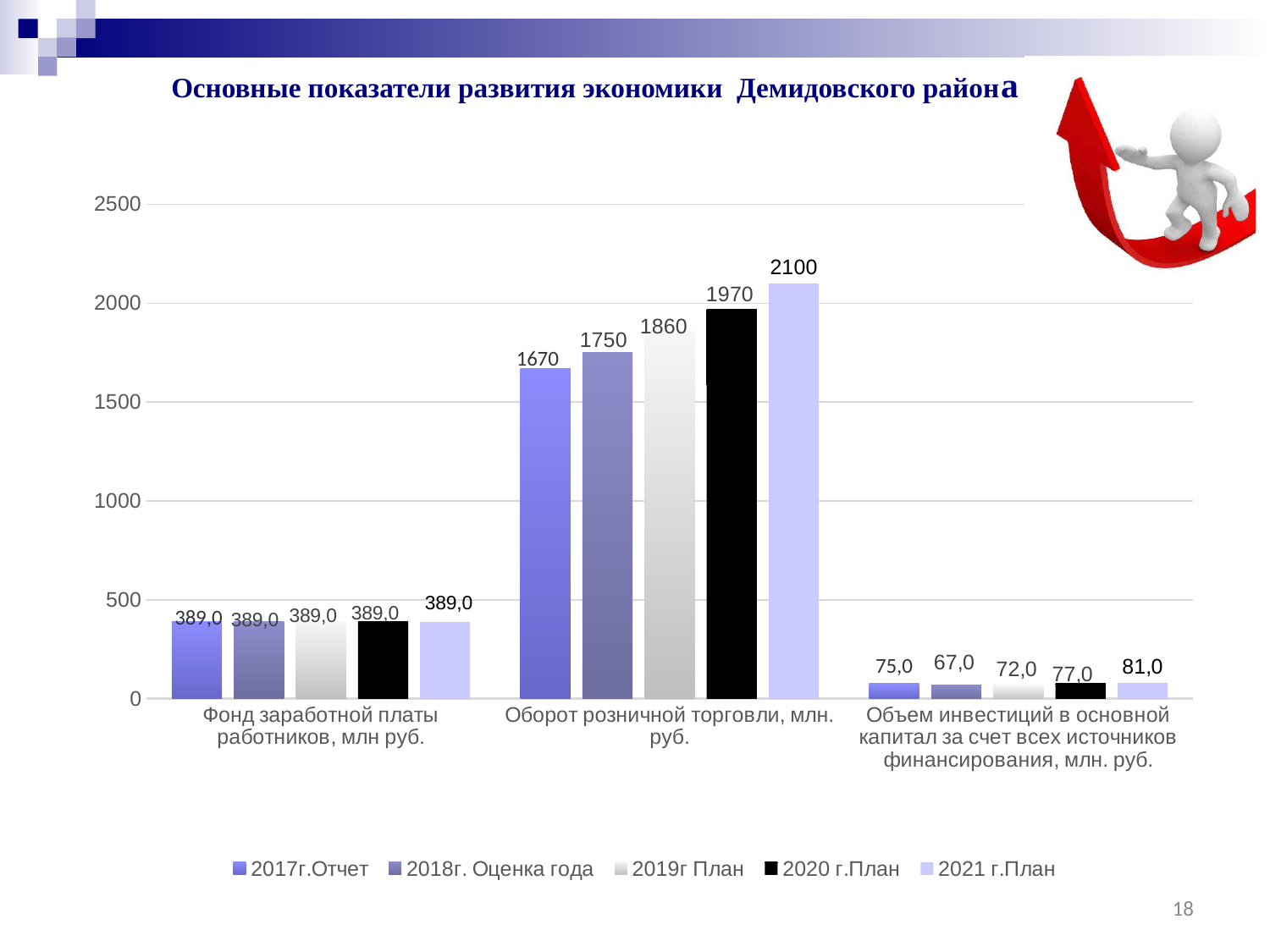
How many categories are shown on the x axis? 3 Which is larger for 'Объем инвестиций в основной капитал за счет всех источников финансирования, млн. руб.': the '2017г.Отчет' value or the '2019г План' value? 2017г.Отчет What type of chart is shown on the slide? bar chart Do the values for 'Оборот розничной торговли, млн. руб.' rise or fall from '2017г.Отчет' to '2021 г.План'? rise What is the value of 'Оборот розничной торговли, млн. руб.' for the series '2021 г.План'? 2100 Which series has the highest value for 'Оборот розничной торговли, млн. руб.'? 2021 г.План What is the value of 'Фонд заработной платы работников, млн руб.' for the series '2017г.Отчет'? 389,0 What is the title of the slide? Основные показатели развития экономики Демидовского района What is the value of 'Объем инвестиций в основной капитал за счет всех источников финансирования, млн. руб.' for the series '2018г. Оценка года'? 67,0 Which series has the lowest value for 'Объем инвестиций в основной капитал за счет всех источников финансирования, млн. руб.'? 2018г. Оценка года How many series does the legend list? 5 What is the difference between the '2021 г.План' and '2017г.Отчет' values for 'Оборот розничной торговли, млн. руб.'? 430